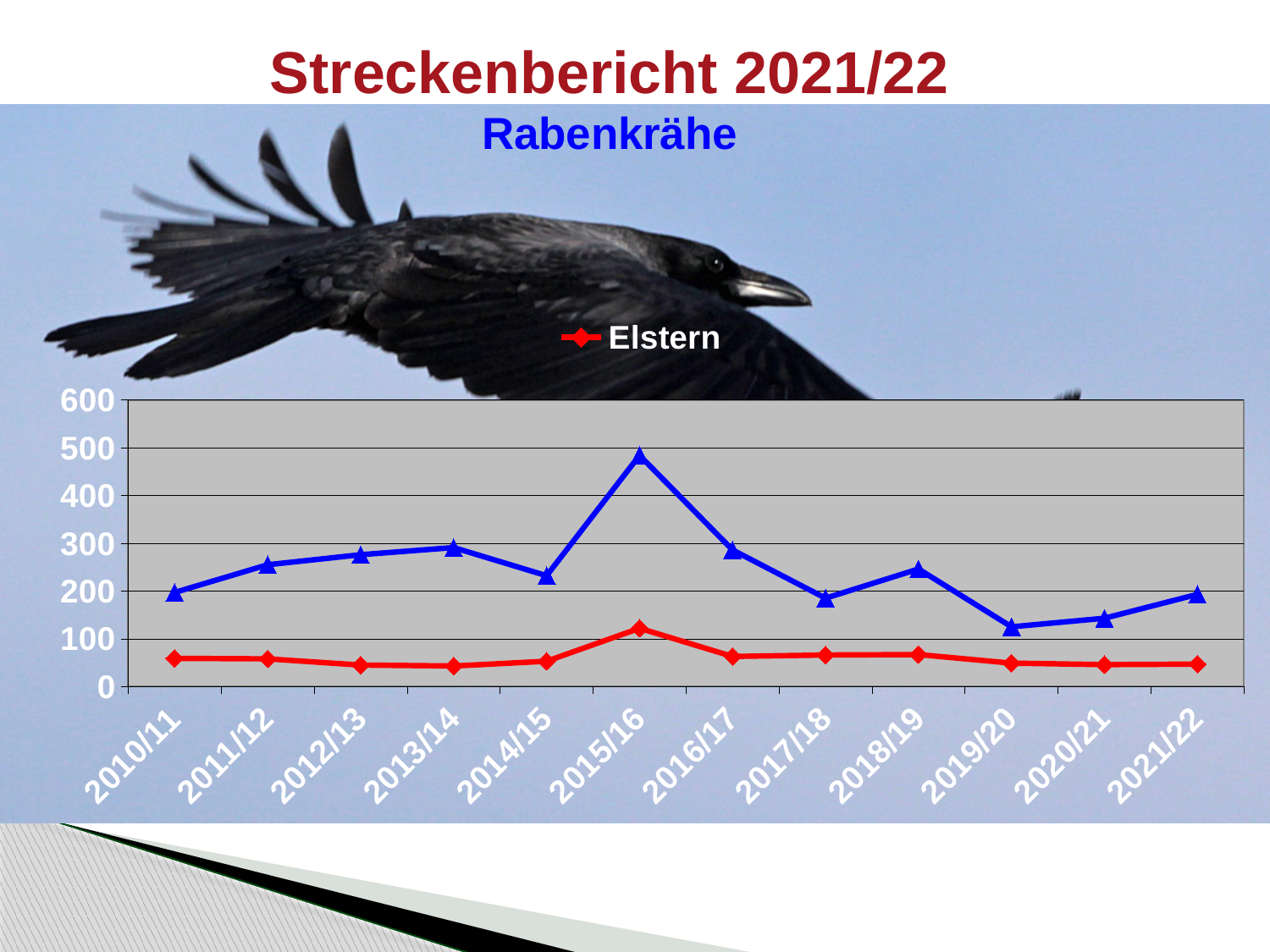
In which season does the red Elstern line reach its highest value? 2015/16 What colour is the Elstern series in the legend? red How many lines are plotted in the chart? 2 In which season is the blue line at its lowest value? 2019/20 What kind of chart is shown on the slide? line chart Does the blue line rise or fall from 2015/16 to 2019/20? fall In which season does the blue line reach its highest value? 2015/16 Which line has the larger value in 2018/19, the blue line or the red Elstern line? the blue line Is the value of the blue line for 2019/20 greater or less than 200? less Is the value of the blue line for 2015/16 greater or less than 400? greater Is the value of the Elstern line for 2012/13 greater or less than 100? less How many seasons are plotted along the x axis? 12